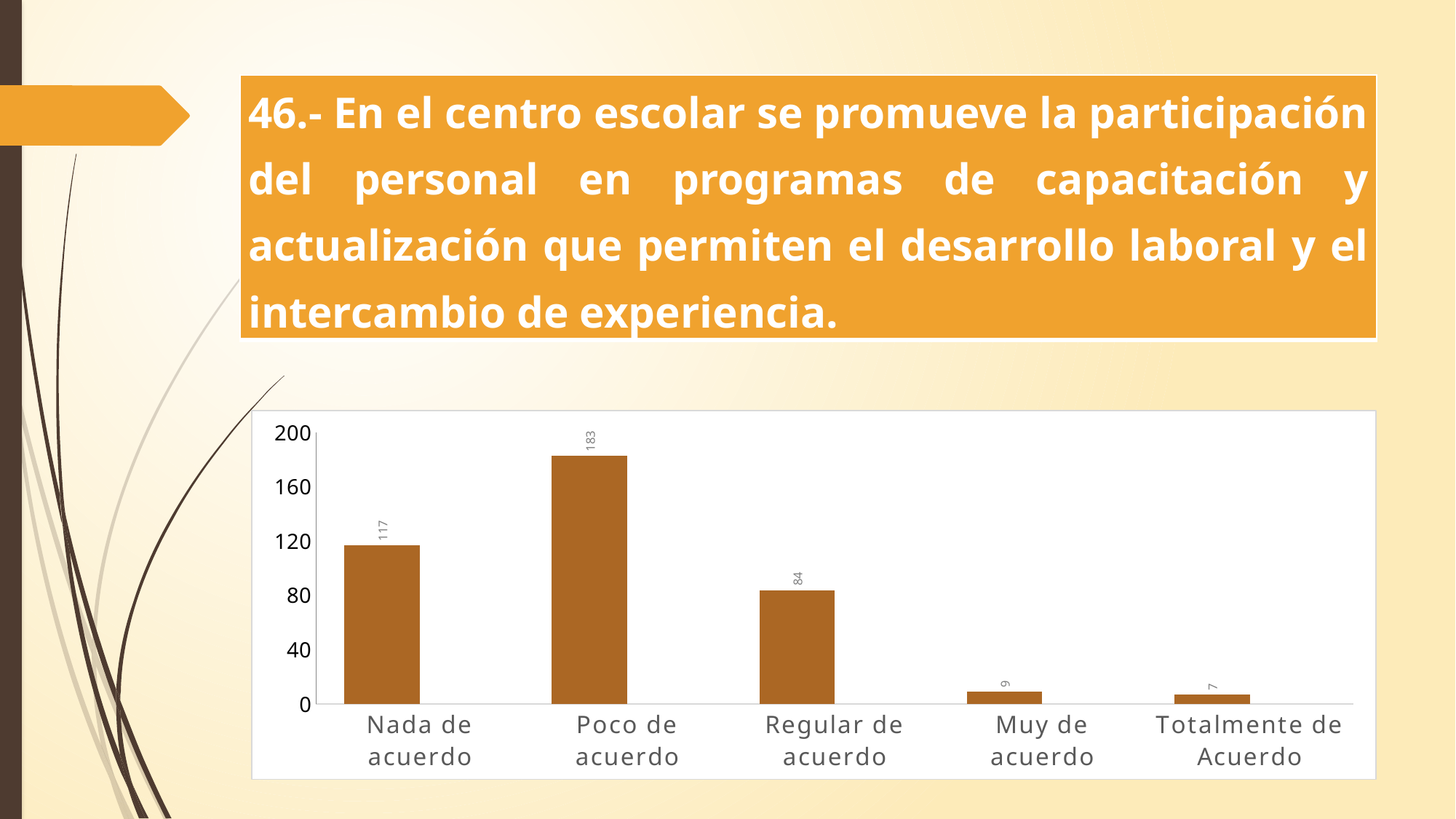
What is the difference between the values for "Poco de acuerdo" and "Nada de acuerdo"? 66 What is the value for "Totalmente de Acuerdo"? 7 What is the highest value shown on the y axis? 200 Which is larger, the value for "Regular de acuerdo" or the value for "Muy de acuerdo"? Regular de acuerdo Which category has the highest value? Poco de acuerdo What is the value for "Regular de acuerdo"? 84 Which category has the lowest value? Totalmente de Acuerdo Is the value for "Nada de acuerdo" greater or less than 80? greater What is the value for "Poco de acuerdo"? 183 What is the value for "Nada de acuerdo"? 117 What kind of chart is shown on the slide? bar chart How many categories are shown on the x axis? 5